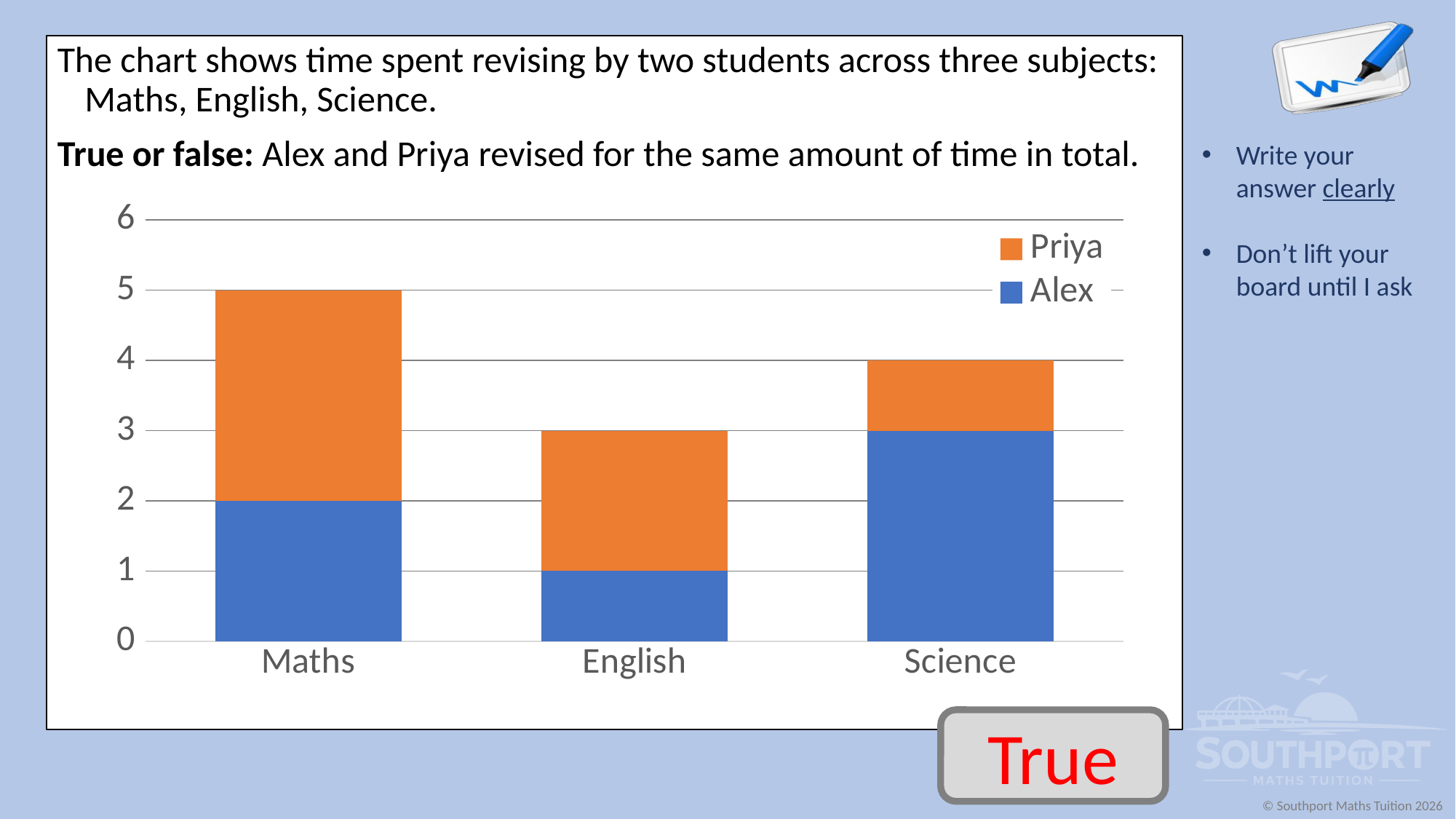
What is the value for Alex in Science? 3 How many series does the chart's legend list? 2 Which subject has the highest total stacked bar? Maths What is the total height of the stacked bar for English? 3 What is the difference between the total for Maths and the total for English? 2 What kind of chart is shown on the slide? stacked bar chart What is the total height of the stacked bar for Maths? 5 Which subject has the lowest total stacked bar? English Which series is shown in orange in the chart's legend? Priya How many subjects are shown on the x axis of the chart? 3 What is the total height of the stacked bar for Science? 4 What is the value for Alex in Maths? 2